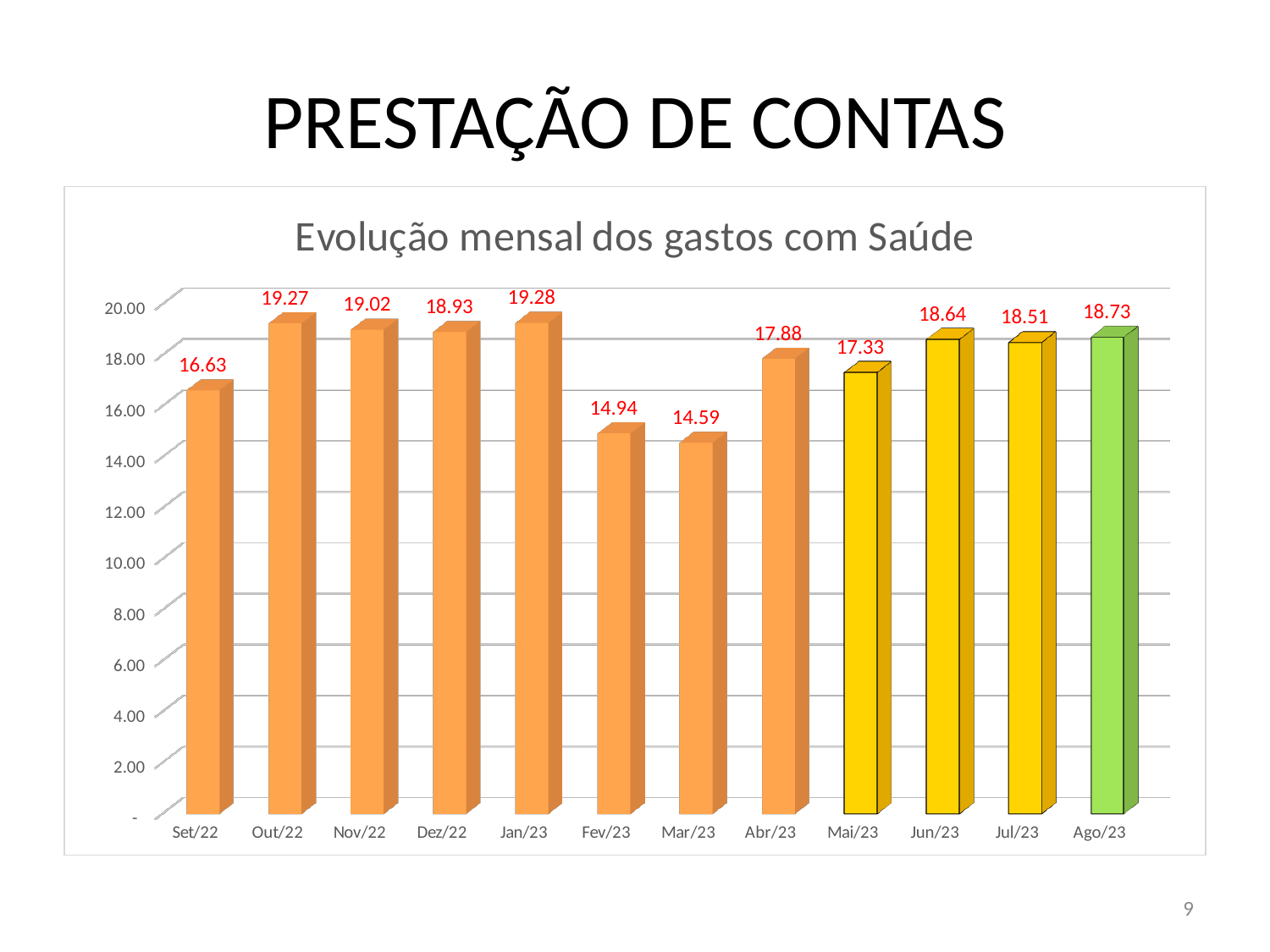
What is the value for Jan/23 in the chart? 19.28 What is the difference between the values for Out/22 and Set/22? 2.64 What is the value for Ago/23 in the chart? 18.73 What is the difference between the values for Jan/23 and Mar/23? 4.69 Which month has the highest value in the chart? Jan/23 What is the title of the chart? Evolução mensal dos gastos com Saúde Is the value for Mai/23 greater or less than 16.00? greater Which month has the lowest value in the chart? Mar/23 What is the value for Mar/23 in the chart? 14.59 How many months are shown on the x axis of the chart? 12 Which is larger, the value for Fev/23 or the value for Abr/23? Abr/23 What kind of chart is shown on the slide? bar chart